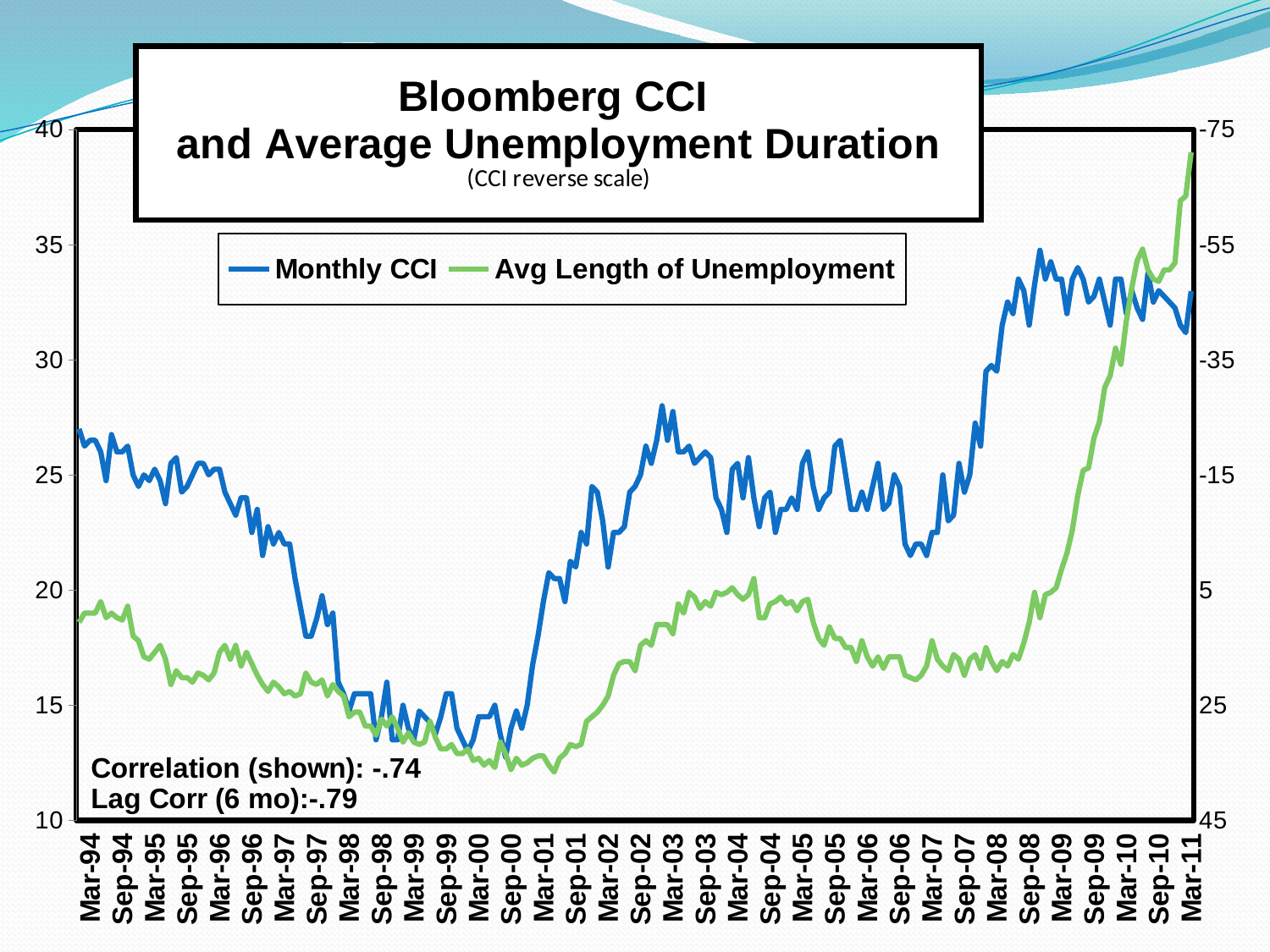
What kind of chart is shown on the slide? line chart What note in parentheses appears under the chart title? (CCI reverse scale) Is the value of Avg Length of Unemployment at Sep-00 greater or less than 15 on the left axis? less Is the value of Avg Length of Unemployment at Mar-94 greater or less than 20 on the left axis? less Is the value of Avg Length of Unemployment at Mar-11 greater or less than 35 on the left axis? greater At which x-axis label does the Avg Length of Unemployment line reach its highest point? Mar-11 Which is larger for Avg Length of Unemployment: the value at Mar-09 or the value at Mar-08? Mar-09 Which series is drawn in green? Avg Length of Unemployment What is the correlation (shown) printed on the chart? -.74 What is the 6-month lag correlation printed on the chart? -.79 Does the Avg Length of Unemployment line rise or fall between Mar-08 and Mar-11? rise How many series does the legend list? 2